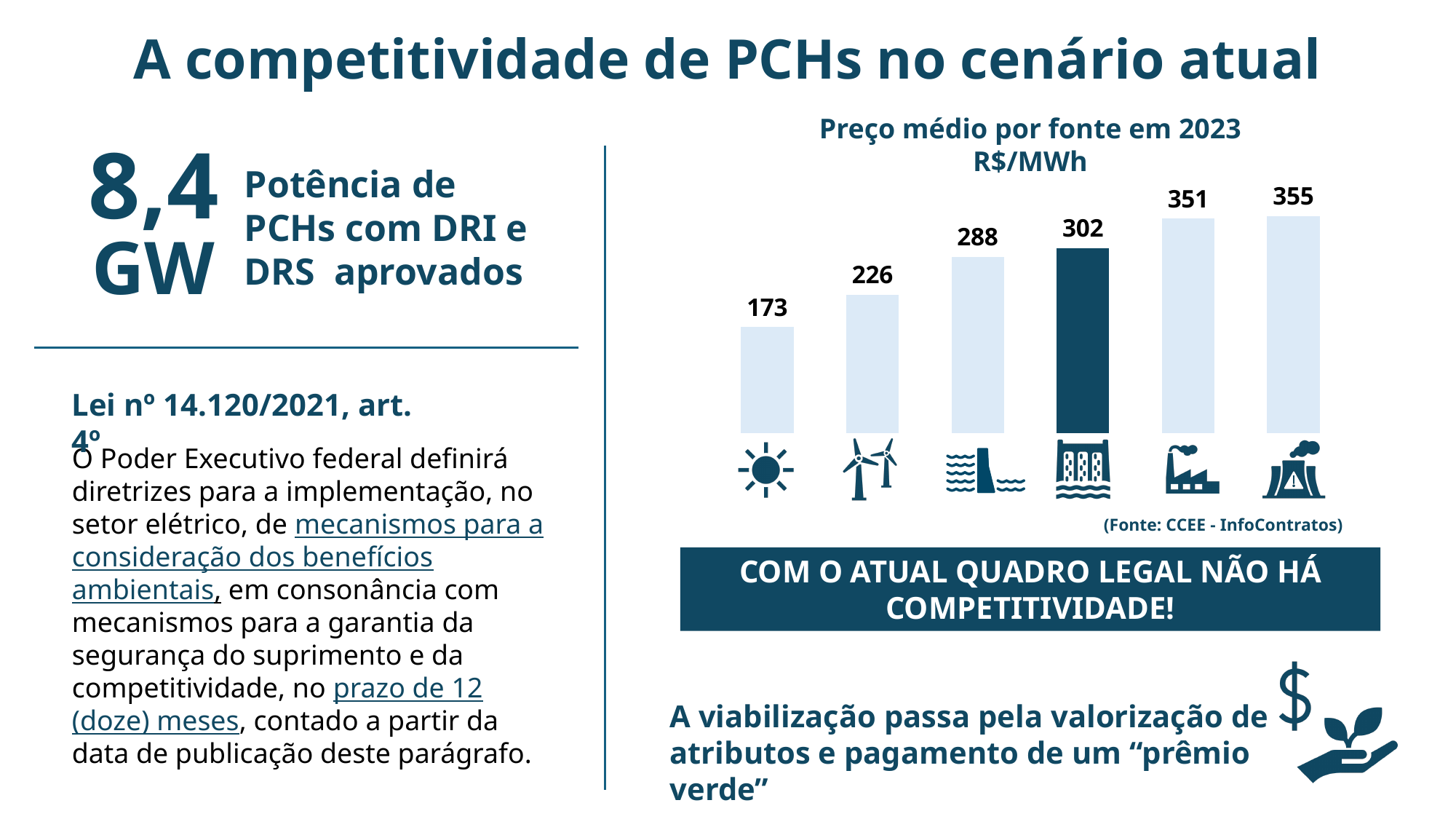
What is the difference between the dark highlighted bar (302) and the third bar from the left (288)? 14 What is the highest value shown in the chart? 355 What is the value of the dark highlighted bar (fourth from the left)? 302 What is the value of the second bar from the left (wind turbine icon)? 226 How many bars does the chart have? 6 Which is larger: the fifth bar from the left or the rightmost bar? the rightmost bar (355) What type of chart is shown on the slide? bar chart What is the difference between the rightmost bar (355) and the leftmost bar (173)? 182 What is the value of the leftmost bar (sun icon)? 173 What is the title of the chart? Preço médio por fonte em 2023 R$/MWh What is the lowest value shown in the chart? 173 Do the bar values rise or fall from left to right across the chart? rise